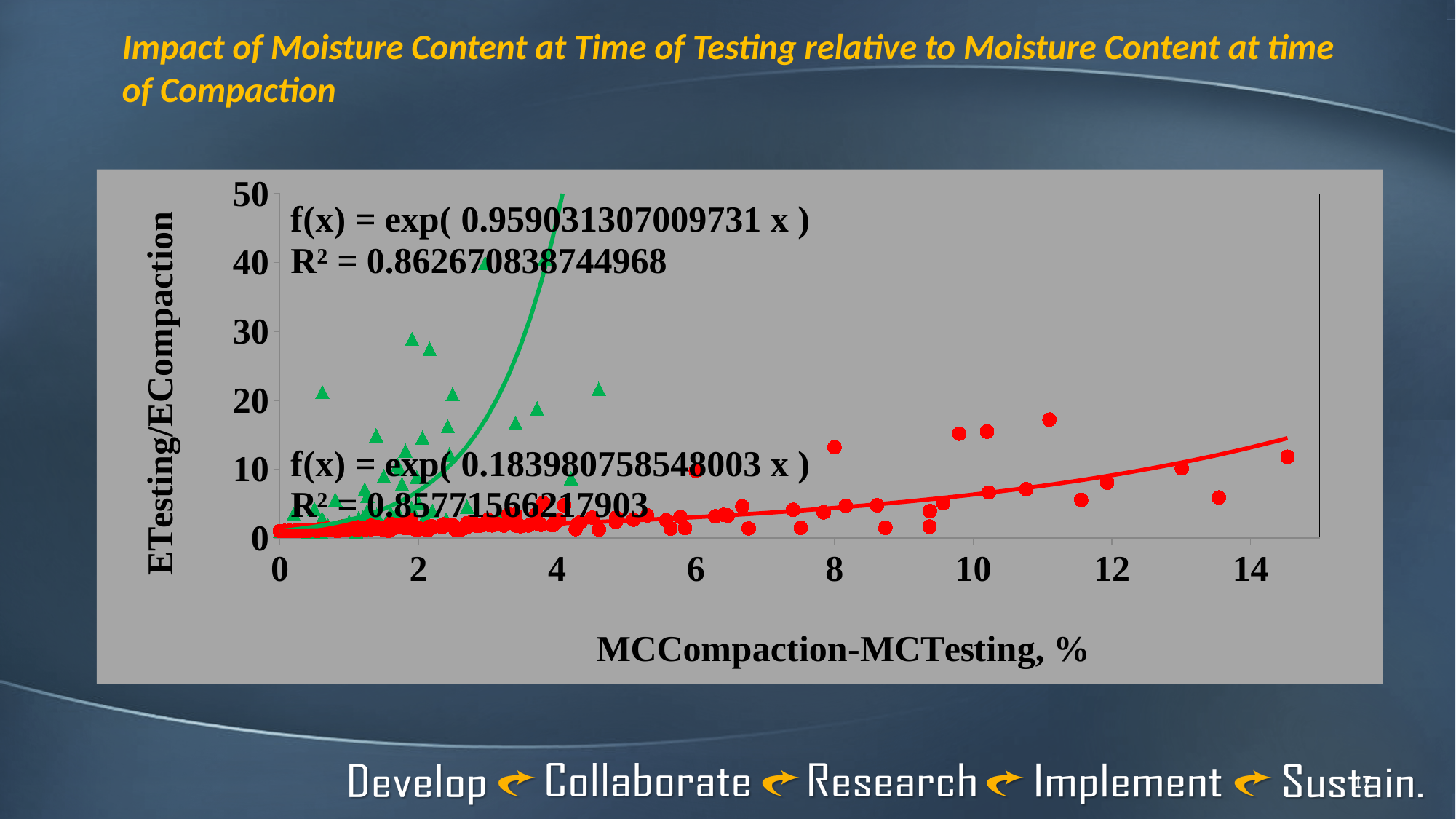
Which trendline has the larger R² value, the upper (green) one or the lower (red) one? the upper (green) one What kind of chart is shown on the slide? scatter chart Is the red circle data point near x = 11 greater or less than 10 on the y axis? greater What is the title of the x axis of the chart? MCCompaction-MCTesting, % What is the R² value printed for the green trendline (the upper equation)? 0.862670838744968 What is the coefficient of x in the upper trendline equation f(x) = exp( ... x )? 0.959031307009731 What is the coefficient of x in the lower trendline equation f(x) = exp( ... x )? 0.183980758548003 Is the highest green triangle data point (near x = 3) greater or less than 30 on the y axis? greater What is the maximum value shown on the y axis? 50 Do the red circle data points generally rise or fall as the x value increases? rise What is the title of the y axis of the chart? ETesting/ECompaction What is the R² value printed for the red trendline (the lower equation)? 0.85771566217903